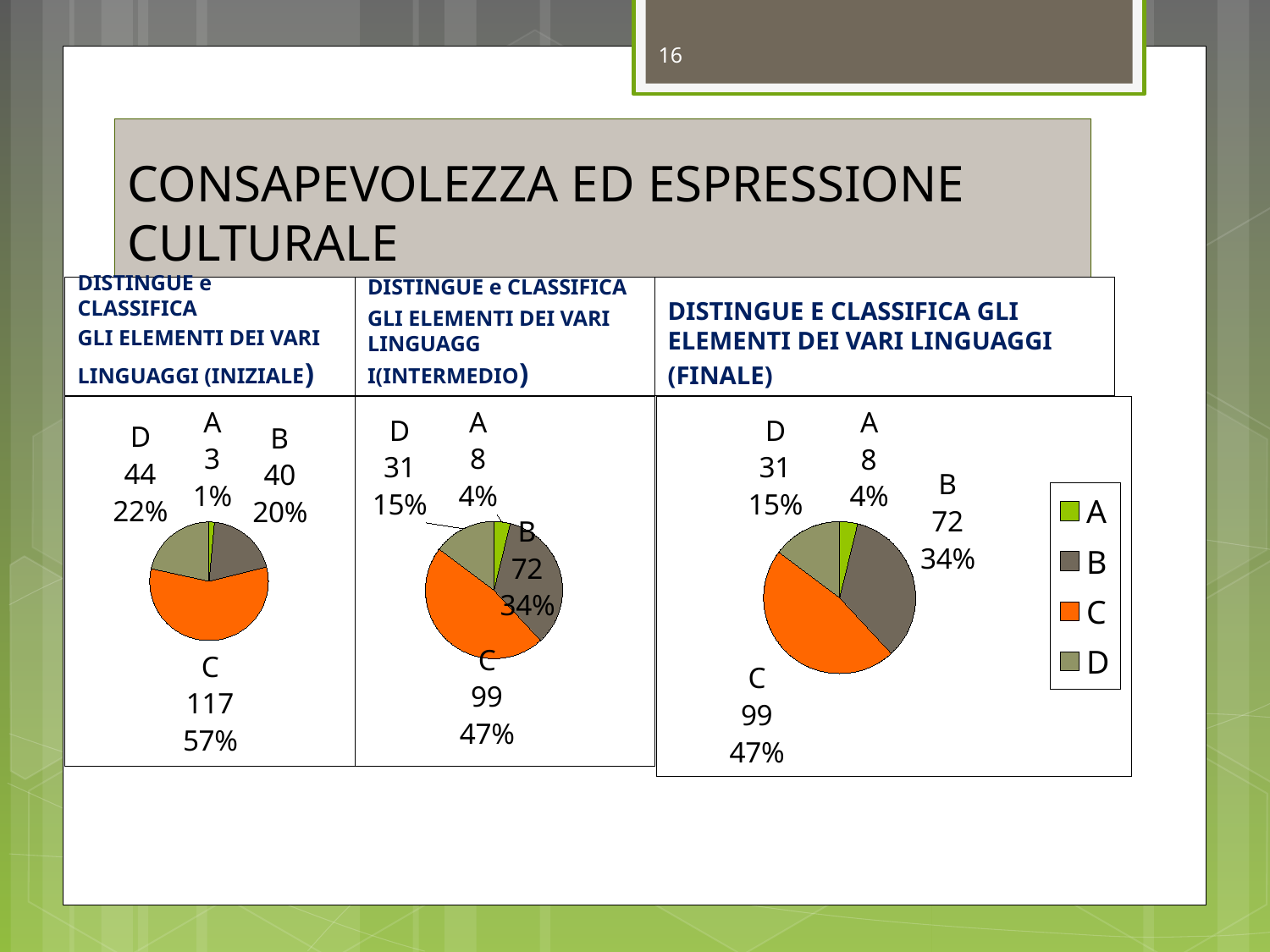
In the FINALE pie chart (right), what is the difference between the values for C and D? 68 In the INTERMEDIO pie chart (middle), what percentage share does category A have? 4% In the INTERMEDIO pie chart (middle), what is the value for category B? 72 In the INIZIALE pie chart (left), what is the difference between the values for C and B? 77 In the INIZIALE pie chart (left), which category has the smallest slice? A What type of chart is used in the INIZIALE panel (left)? Pie chart In the INIZIALE pie chart (left), what is the value for category C? 117 In the FINALE pie chart (right), which is larger, the value for B or the value for D? B How many categories does the legend on the right of the FINALE chart list? 4 In the INTERMEDIO pie chart (middle), which category has the largest slice? C In the INIZIALE pie chart (left), what percentage share does category D have? 22% In the FINALE pie chart (right), what is the value for category D? 31